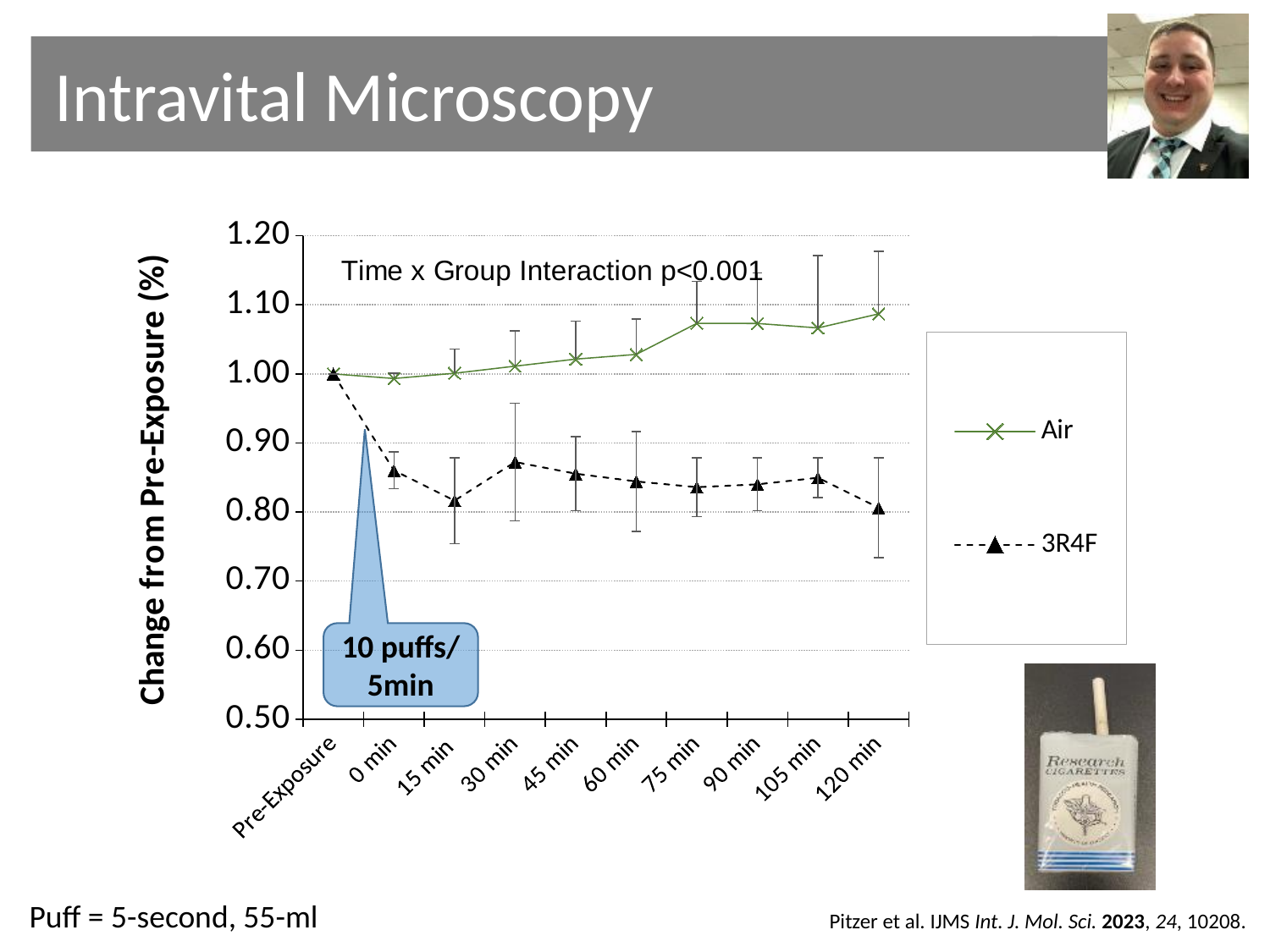
How many time points are plotted along the x axis? 10 Is the value for Air at 120 min greater or less than 1.00? greater What statistical annotation is printed inside the chart area? Time x Group Interaction p<0.001 What is the value for the Air series at Pre-Exposure? 1.00 Is the value for 3R4F at 120 min greater or less than 0.90? less Does the Air series generally rise or fall from Pre-Exposure to 120 min? rise How many series does the legend list? 2 What is the y-axis title of the chart? Change from Pre-Exposure (%) Does the 3R4F series rise or fall from Pre-Exposure to 0 min? fall At 60 min, which series has the larger value, Air or 3R4F? Air Is the value for 3R4F at 15 min greater or less than 0.90? less What kind of chart is shown on the slide? line chart